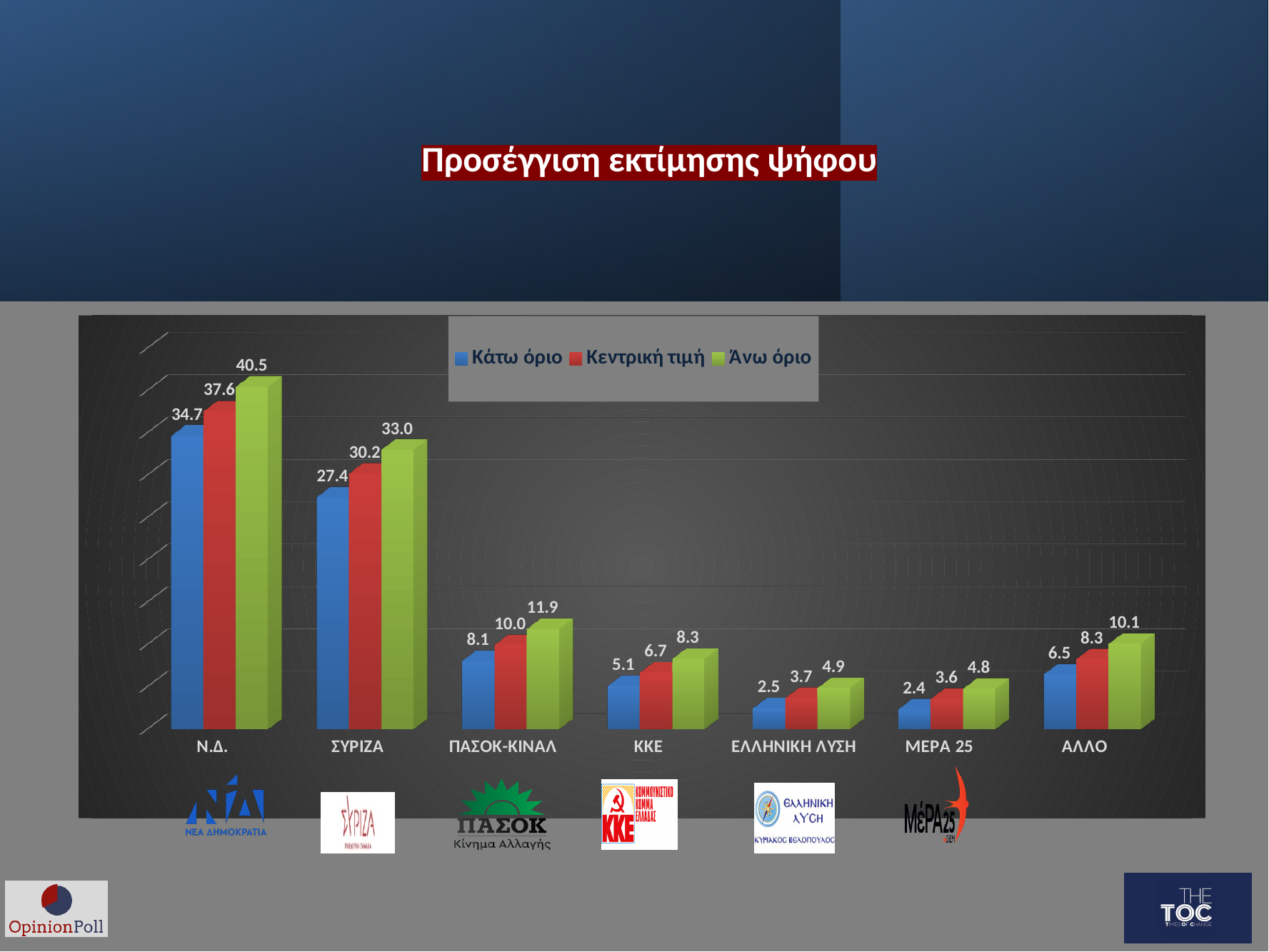
Which category has the lowest Κάτω όριο value? ΜΕΡΑ 25 Which is larger, the Κεντρική τιμή value for ΑΛΛΟ or for ΚΚΕ? ΑΛΛΟ What is the Άνω όριο value for ΣΥΡΙΖΑ? 33.0 What is the difference between the Κεντρική τιμή values for Ν.Δ. and ΣΥΡΙΖΑ? 7.4 What kind of chart is shown on the slide? Bar chart What is the Κάτω όριο value for ΠΑΣΟΚ-ΚΙΝΑΛ? 8.1 What is the Κεντρική τιμή value for Ν.Δ.? 37.6 What is the Κεντρική τιμή value for ΚΚΕ? 6.7 How many series does the legend list? 3 Which category has the highest Κεντρική τιμή value? Ν.Δ. How many categories are shown on the x axis? 7 What is the difference between the Άνω όριο and Κάτω όριο values for Ν.Δ.? 5.8